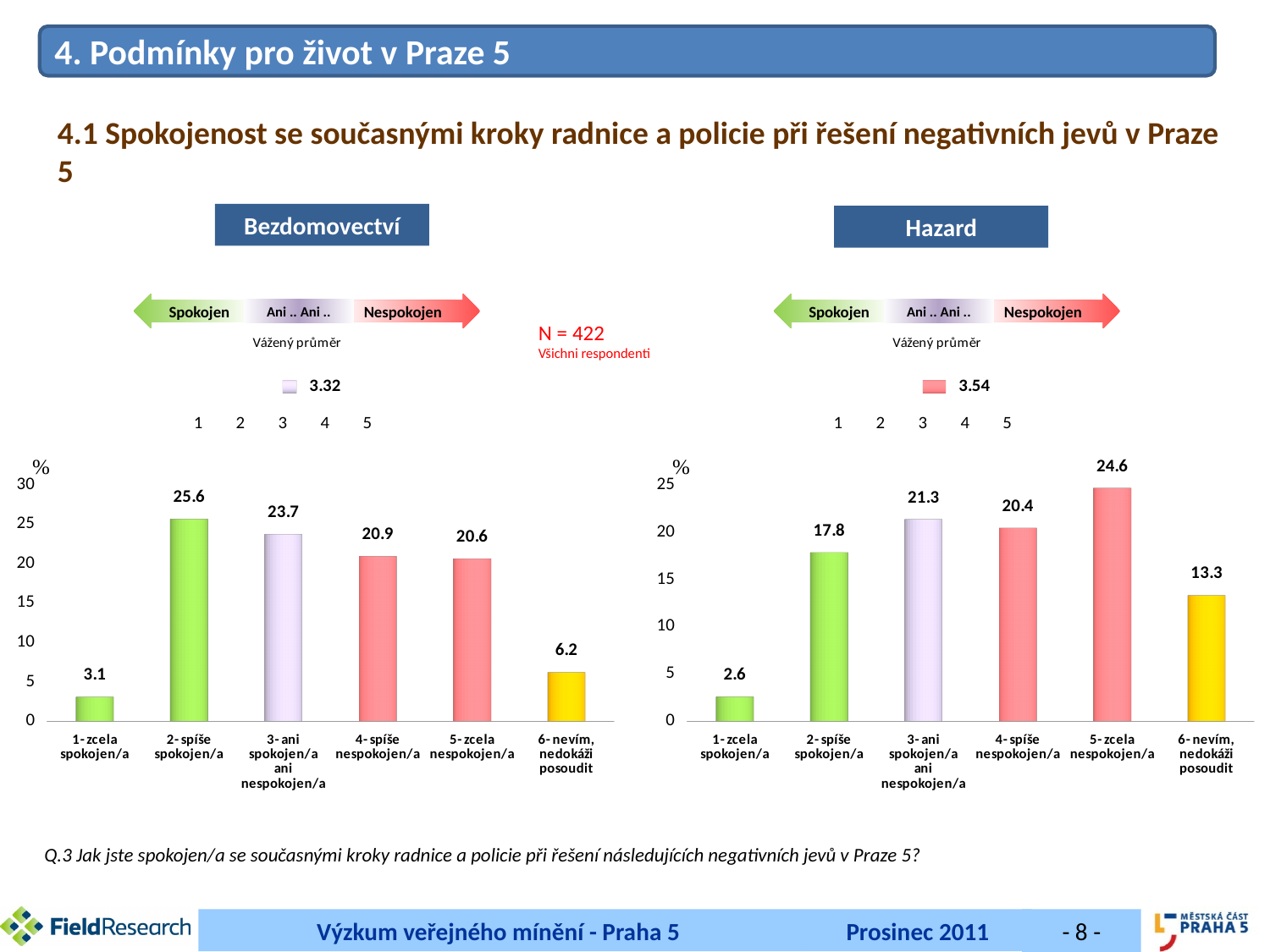
What kind of chart is the Bezdomovectví chart? bar chart In the Bezdomovectví chart, which category has the highest value? 2- spíše spokojen/a Which is larger: the value for "6- nevím, nedokáži posoudit" in the Bezdomovectví chart or in the Hazard chart? Hazard What weighted average (Vážený průměr) is shown for the Hazard chart? 3.54 In the Bezdomovectví chart, what is the difference between the values for "2- spíše spokojen/a" and "3- ani spokojen/a ani nespokojen/a"? 1.9 In the Bezdomovectví chart, what is the value for "2- spíše spokojen/a"? 25.6 In the Hazard chart, what is the value for "6- nevím, nedokáži posoudit"? 13.3 In the Hazard chart, what is the value for "5- zcela nespokojen/a"? 24.6 In the Hazard chart, what is the difference between the values for "5- zcela nespokojen/a" and "2- spíše spokojen/a"? 6.8 In the Bezdomovectví chart, is the value for "4- spíše nespokojen/a" greater or less than 15? greater How many categories are shown on the x axis of the Hazard chart? 6 In the Hazard chart, which category has the lowest value? 1- zcela spokojen/a